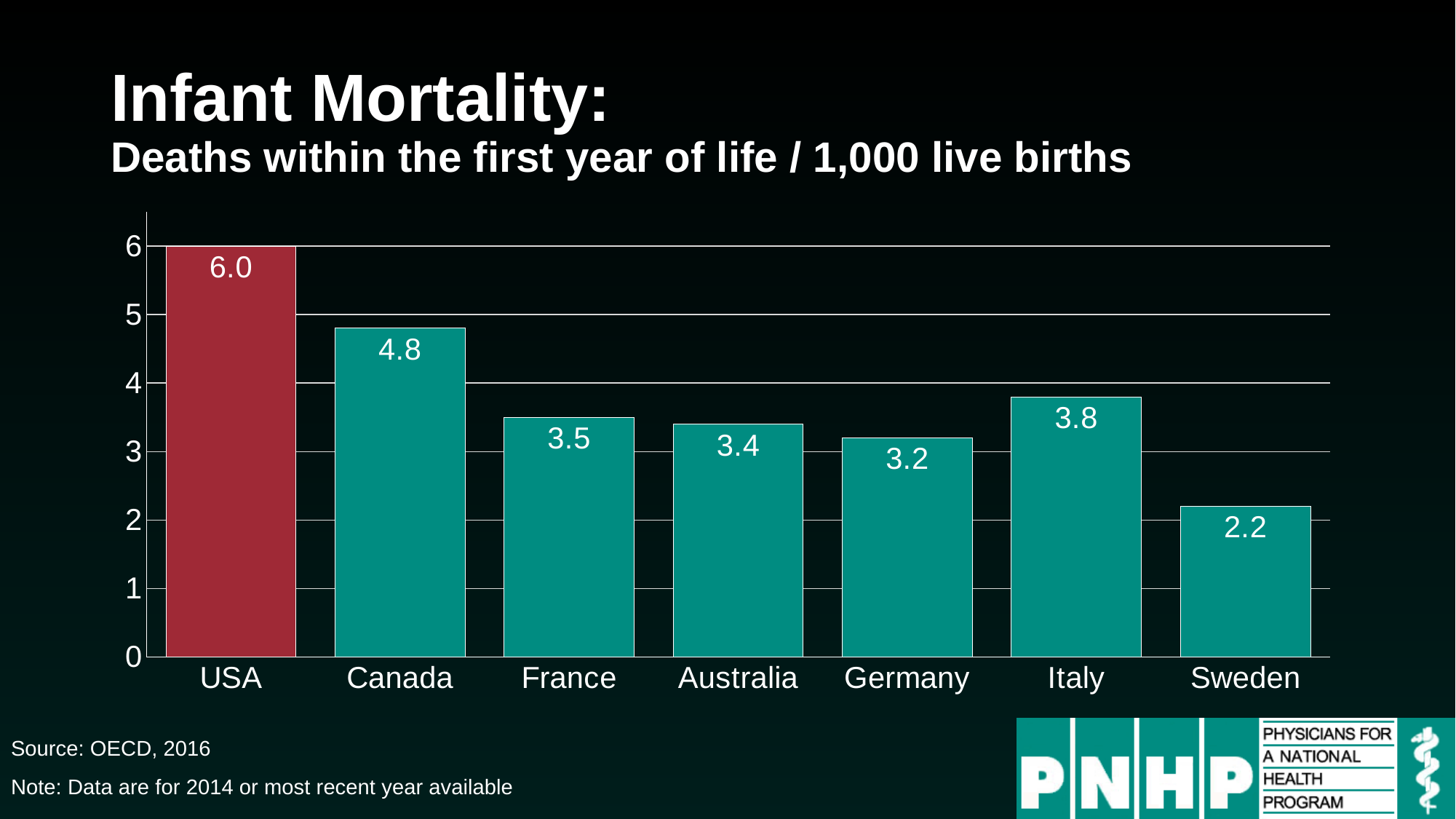
Which bar is shown in a different colour (red) from the others? USA Which has a higher value, Italy or France? Italy What is the difference between the values for the USA and Sweden? 3.8 What is the value shown for Italy? 3.8 What is the infant mortality rate shown for the USA? 6.0 Which country has the highest infant mortality rate on the chart? USA Which country has the lowest infant mortality rate on the chart? Sweden How many countries are shown on the chart? 7 What is the difference between the values for Canada and Germany? 1.6 What is the value shown for Sweden? 2.2 What is the value shown for Canada? 4.8 What type of chart is shown on the slide? Bar chart